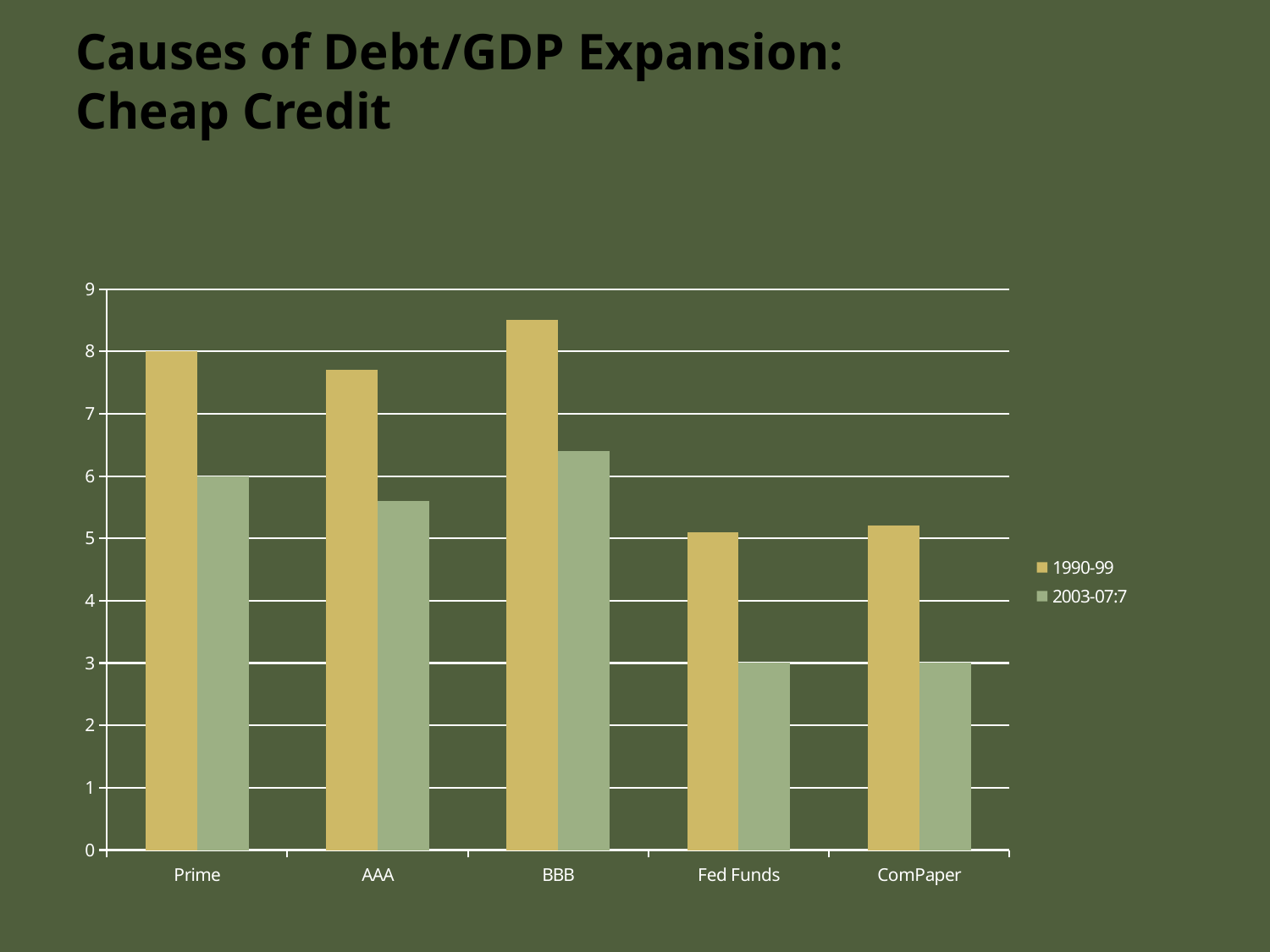
What is the value for Fed Funds in the 2003-07:7 series? 3 Is the value for AAA in the 1990-99 series greater or less than 7? greater Which category has the highest value in the 1990-99 series? BBB What kind of chart is shown on the slide? bar chart What is the value for Prime in the 1990-99 series? 8 What is the difference between the 1990-99 and 2003-07:7 values for Prime? 2 How many categories are shown on the x axis of the chart? 5 Which is larger in the 1990-99 series, Prime or AAA? Prime What is the value for Prime in the 2003-07:7 series? 6 Which category has the highest value in the 2003-07:7 series? BBB Is the value for AAA in the 2003-07:7 series greater or less than 6? less How many series does the chart's legend list? 2